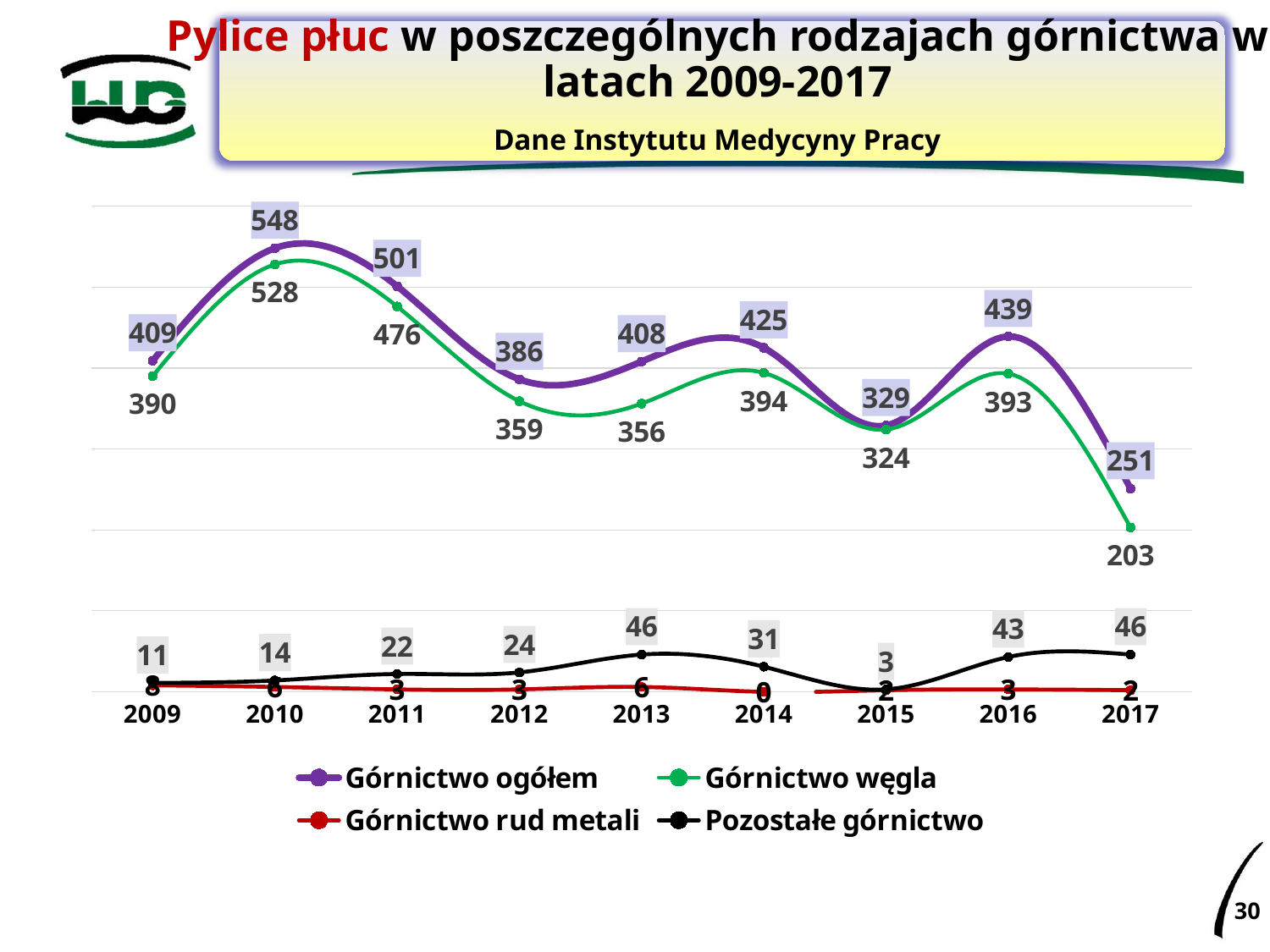
What is the difference between Górnictwo ogółem and Górnictwo węgla in 2015? 5 What is the value for Pozostałe górnictwo in 2016? 43 What is the value for Górnictwo ogółem in 2010? 548 What is the difference between the Górnictwo ogółem values for 2010 and 2017? 297 How many years are shown on the x axis? 9 Which year has the larger value for Pozostałe górnictwo, 2013 or 2014? 2013 Does the value for Górnictwo ogółem rise or fall from 2016 to 2017? fall In which year is Górnictwo węgla lowest? 2017 In which year is Górnictwo ogółem highest? 2010 How many series does the legend list? 4 What is the value for Górnictwo węgla in 2017? 203 What kind of chart is shown on the slide? line chart